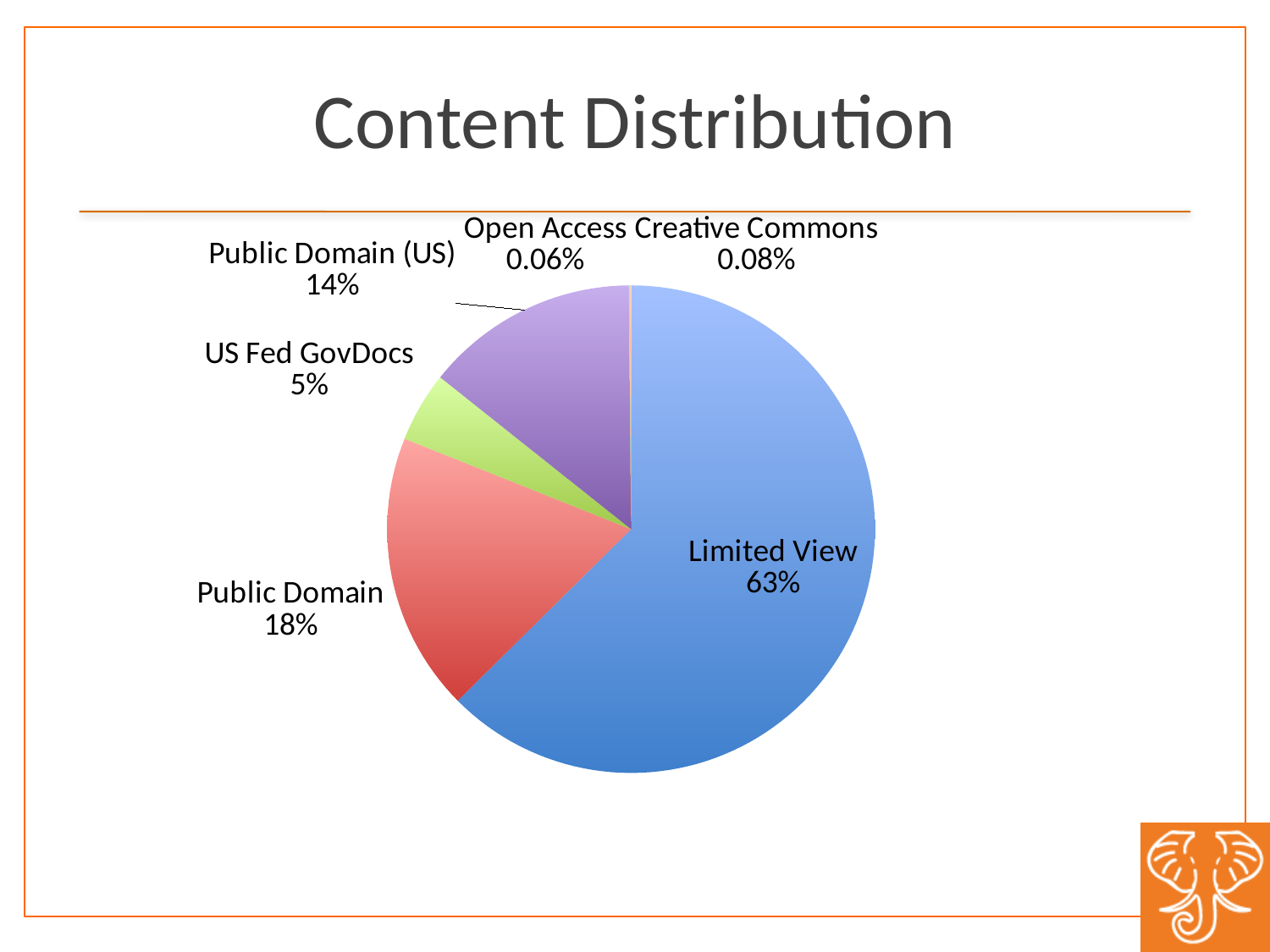
Which category has the smallest share of the pie? Open Access What share of the pie does US Fed GovDocs have? 5% What is the title of the chart? Content Distribution What share of the pie does Open Access have? 0.06% What share of the pie does Public Domain have? 18% What is the difference between the shares of Public Domain and Public Domain (US)? 4% What kind of chart is shown on the slide? pie chart How many categories are shown in the pie chart? 6 Which category has the largest share of the pie? Limited View